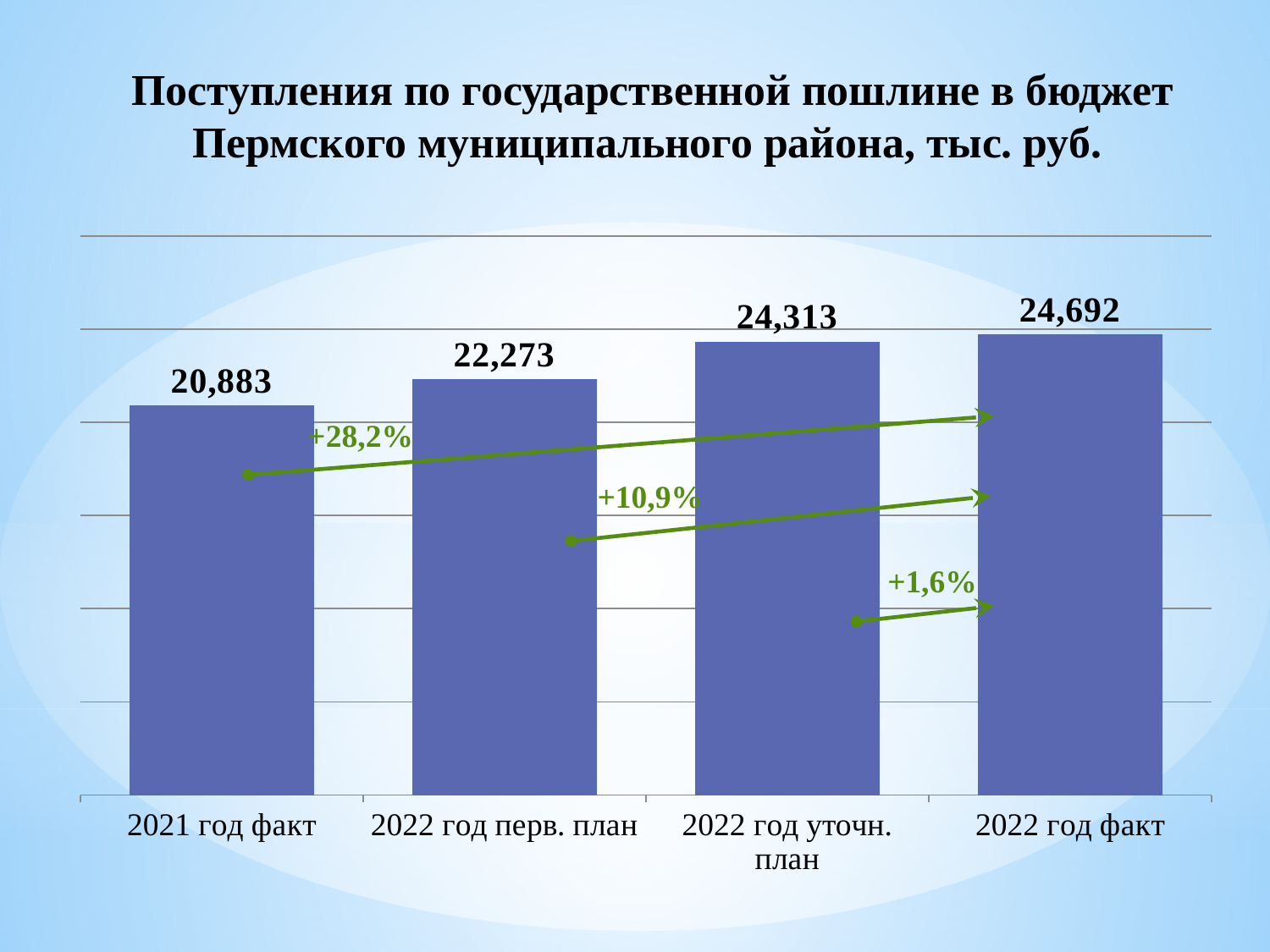
What percentage change is annotated between 2022 год уточн. план and 2022 год факт? +1,6% What is the value for 2022 год уточн. план? 24,313 What kind of chart is shown on the slide? Bar chart What is the difference between the values for 2022 год факт and 2021 год факт? 3,809 Which is larger, the value for 2022 год перв. план or the value for 2021 год факт? 2022 год перв. план What is the difference between the values for 2022 год уточн. план and 2022 год перв. план? 2,040 What is the value for 2021 год факт? 20,883 How many categories are shown on the x axis? 4 What is the value for 2022 год факт? 24,692 Which category has the highest value? 2022 год факт What is the value for 2022 год перв. план? 22,273 Which category has the lowest value? 2021 год факт